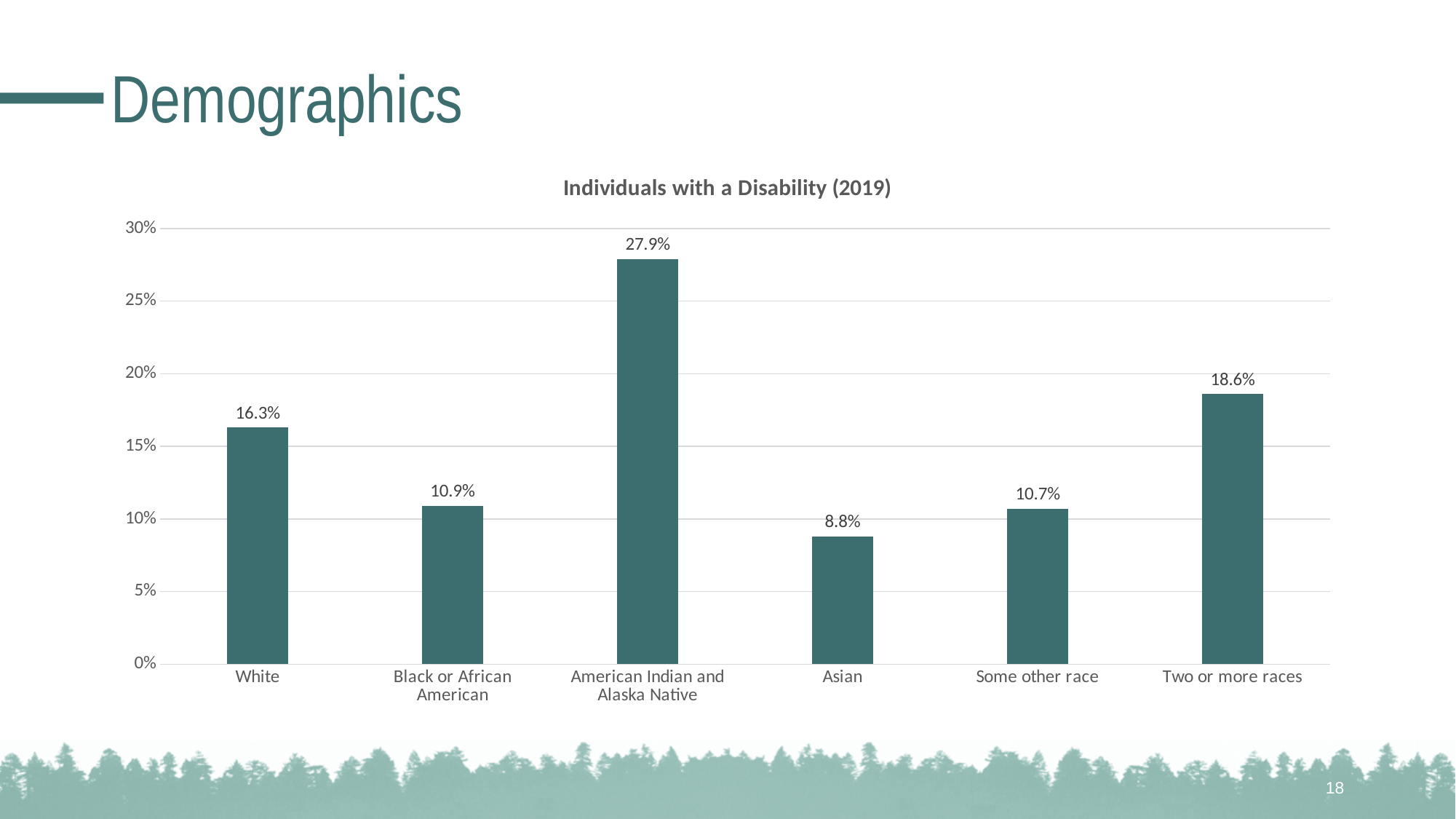
What is the value for Two or more races? 18.6% What is the difference between the values for Two or more races and Some other race? 7.9% Which is larger, the value for White or the value for Black or African American? White Is the value for Some other race greater or less than 15%? less Which category has the lowest value? Asian What kind of chart is this? bar chart Which category has the highest value? American Indian and Alaska Native What is the value for White? 16.3% What is the value for American Indian and Alaska Native? 27.9% What is the difference between the values for American Indian and Alaska Native and White? 11.6% What is the value for Asian? 8.8% How many categories are shown on the x axis? 6